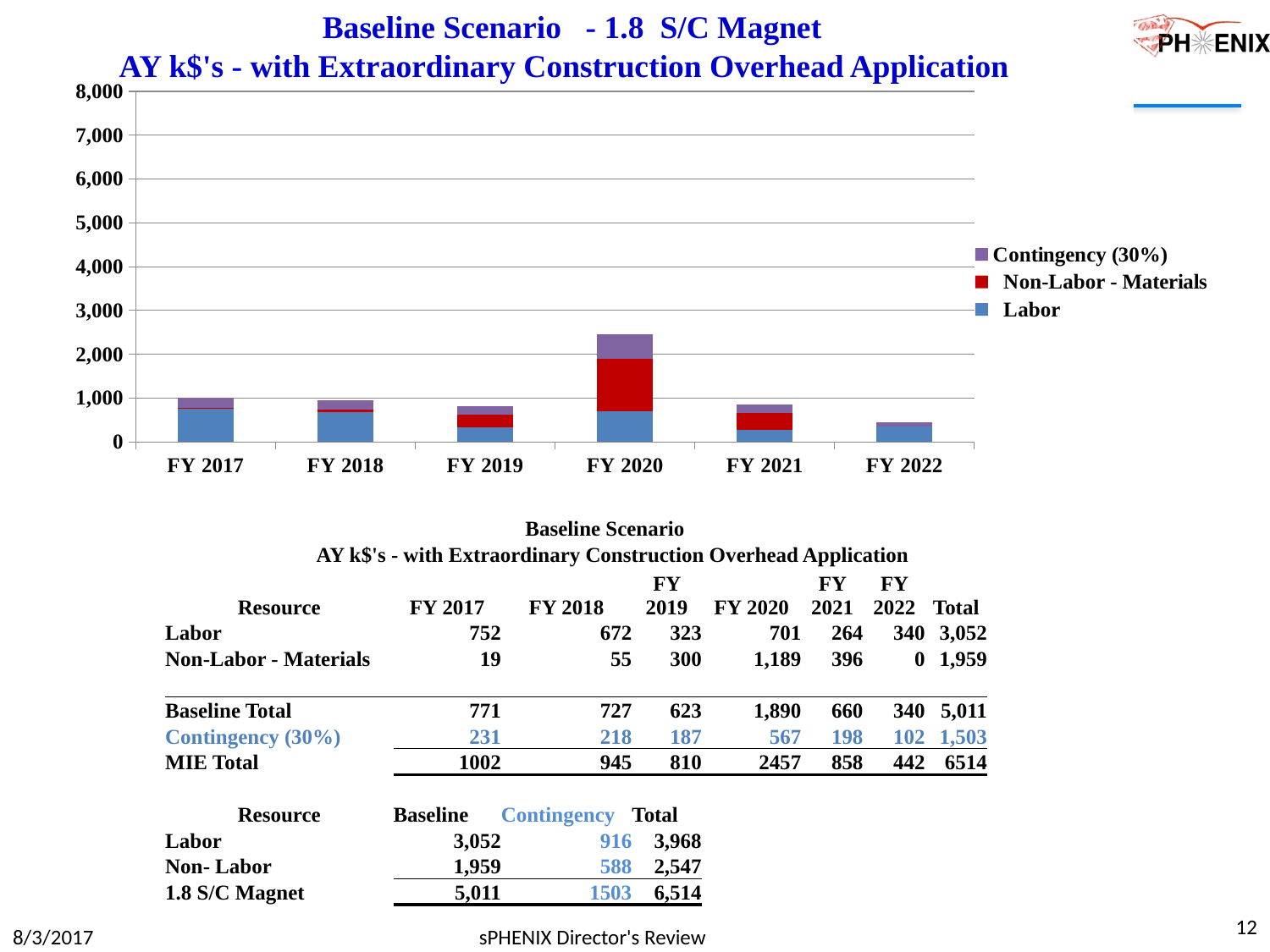
Is the total height of the FY 2021 bar greater or less than 1,000? less Which fiscal year has the tallest stacked bar in the chart? FY 2020 Is the total height of the FY 2020 bar greater or less than 2,000? greater According to the table on the slide, what is the Labor value for FY 2017? 752 According to the table on the slide, what is the Non-Labor - Materials value for FY 2020? 1,189 Which fiscal year has the shortest stacked bar in the chart? FY 2022 How many fiscal years are shown along the x axis of the chart? 6 Which is larger, the Non-Labor - Materials value for FY 2019 or for FY 2021? FY 2021 Using the table values, how much larger is Labor in FY 2018 than in FY 2019? 349 What is the MIE Total (full stacked bar) for FY 2020 as printed in the table? 2457 What kind of chart is shown on the slide? bar chart How many series does the chart legend list? 3